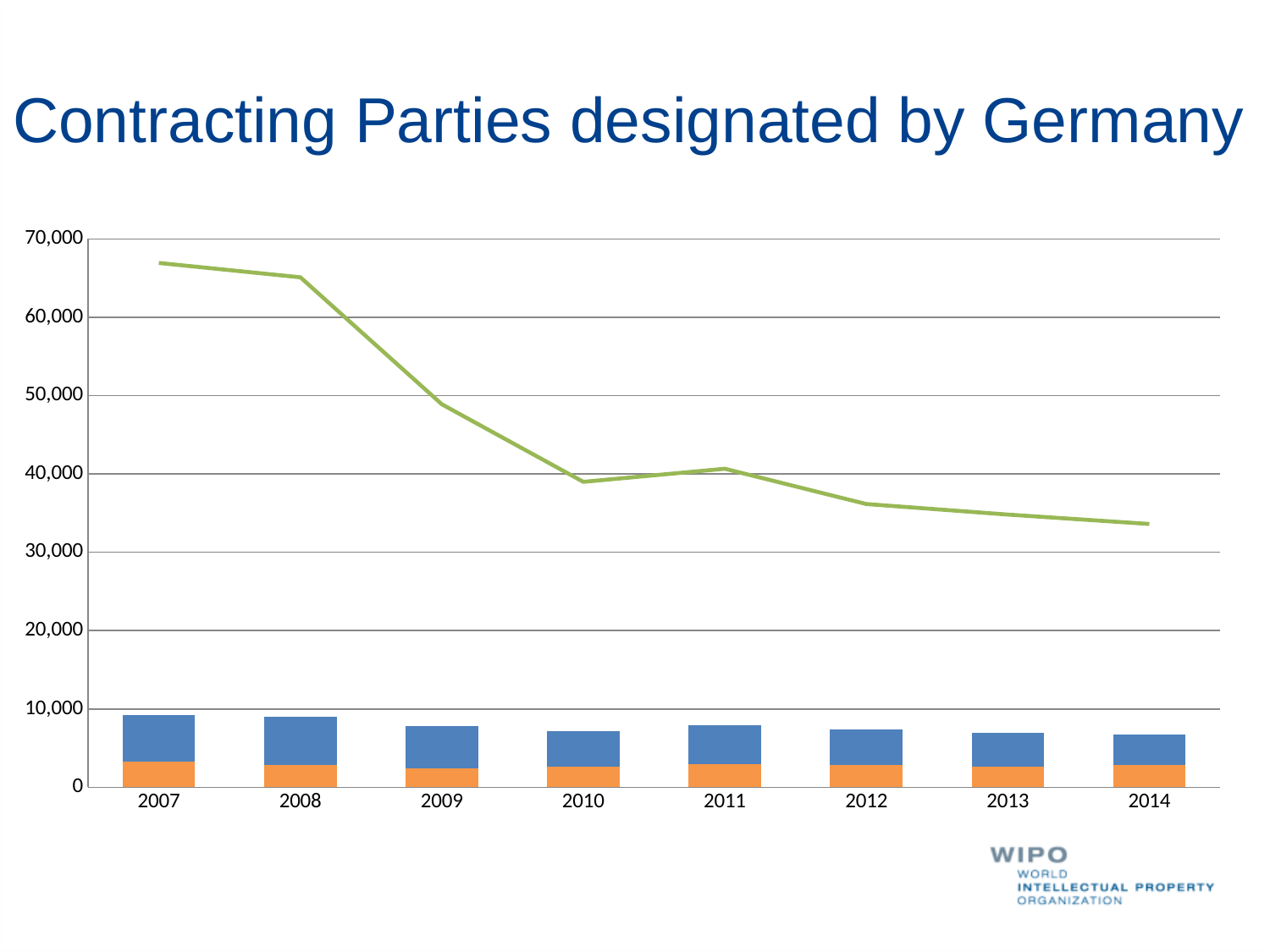
Is the value of the green line for 2014 greater or less than 30,000? greater Which year has the higher value on the green line, 2008 or 2009? 2008 Which year has the taller stacked bar, 2007 or 2014? 2007 Is the value of the green line for 2010 greater or less than 40,000? less What kind of chart is shown on the slide? A combination of a stacked bar chart and a line chart In which year is the green line at its highest? 2007 Is the value of the green line for 2007 greater or less than 60,000? greater What is the title of the chart? Contracting Parties designated by Germany Does the green line rise or fall overall from 2007 to 2014? Fall In which year is the green line at its lowest? 2014 How many years are shown on the x axis? 8